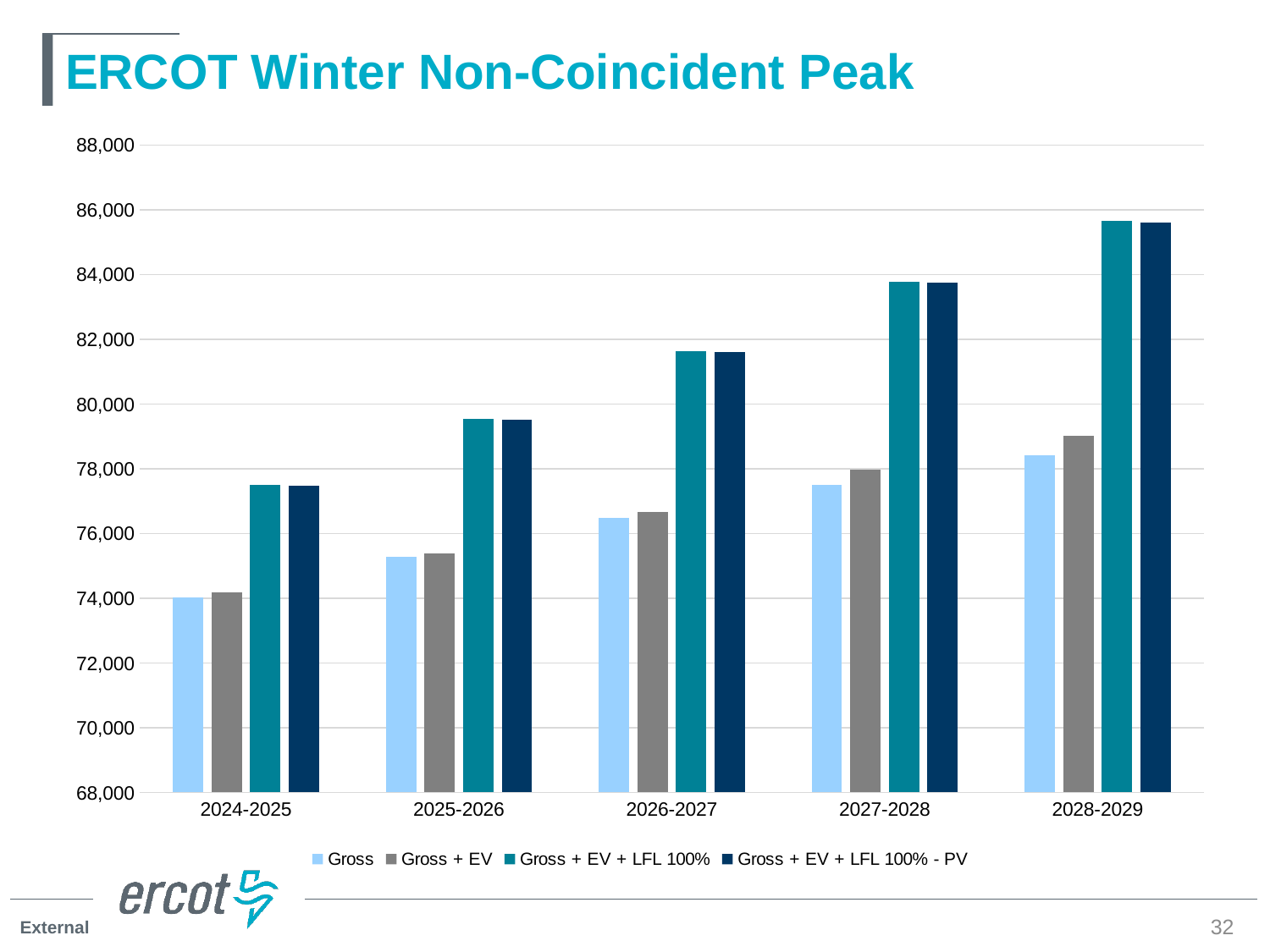
Do the Gross values rise or fall from 2024-2025 to 2028-2029? rise Is the Gross value for 2026-2027 greater or less than 76,000? greater In 2028-2029, which is larger: the Gross value or the Gross + EV + LFL 100% value? Gross + EV + LFL 100% Which winter season has the lowest Gross + EV + LFL 100% value? 2024-2025 What is the title of the chart? ERCOT Winter Non-Coincident Peak What kind of chart is shown on the slide? bar chart Is the Gross value for 2025-2026 greater or less than 76,000? less Is the Gross + EV + LFL 100% value for 2028-2029 greater or less than 86,000? less Which winter season has the highest Gross value? 2028-2029 How many series does the legend list? 4 How many winter seasons (categories) are shown on the x axis? 5